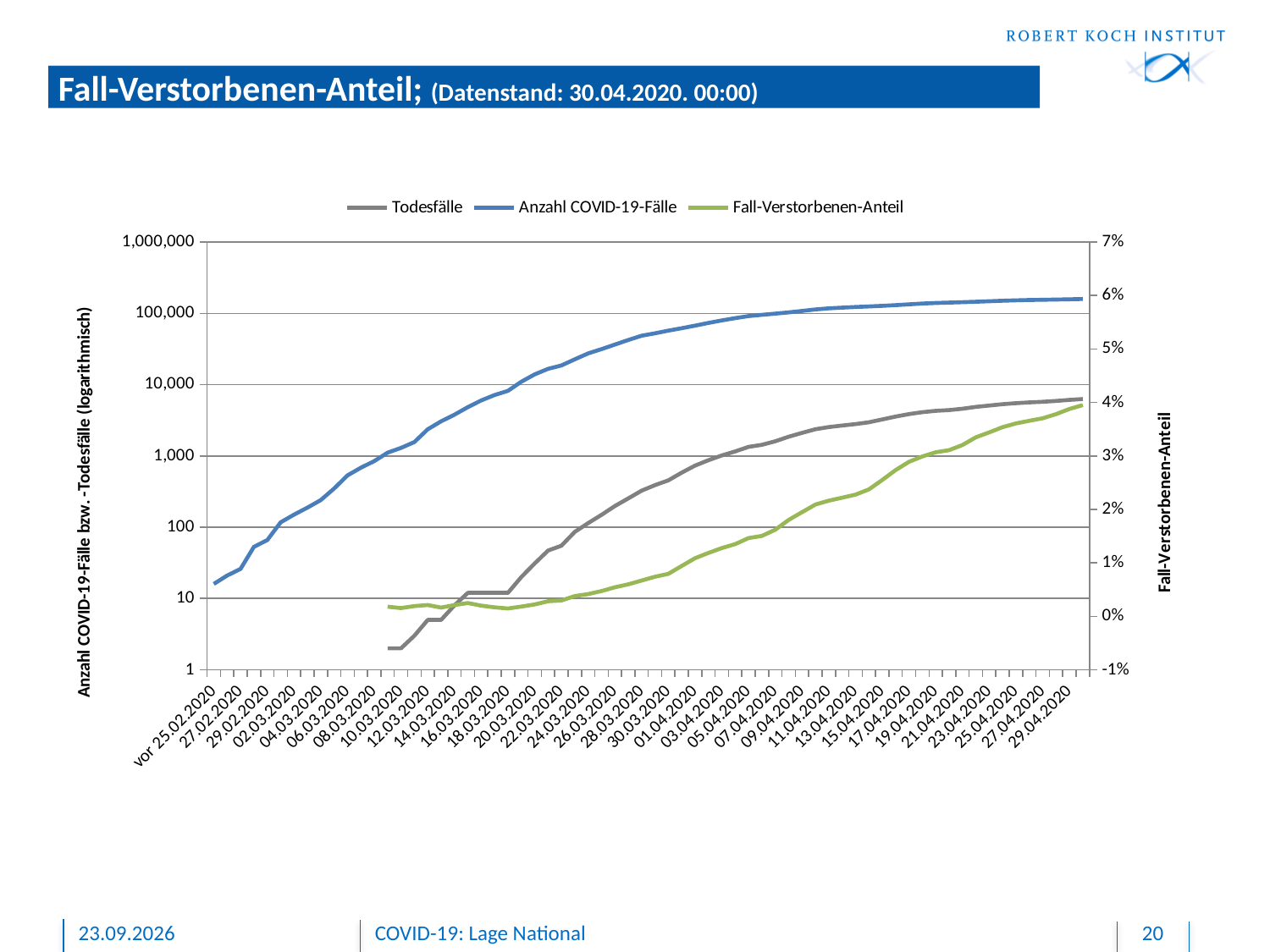
On 29.04.2020, which is larger: Anzahl COVID-19-Fälle or Todesfälle? Anzahl COVID-19-Fälle What kind of chart is shown on the slide? line chart Which series is drawn in green? Fall-Verstorbenen-Anteil How many series does the legend list? 3 Is the value of Todesfälle on 29.04.2020 greater or less than 1,000? greater Is the Fall-Verstorbenen-Anteil on 29.04.2020 greater or less than 3%? greater Is the value of Todesfälle on 10.03.2020 greater or less than 10? less What is the label of the right-hand vertical axis? Fall-Verstorbenen-Anteil Does the Todesfälle series rise or fall over the period shown? rise Does the Anzahl COVID-19-Fälle series rise or fall from left to right along the x axis? rise